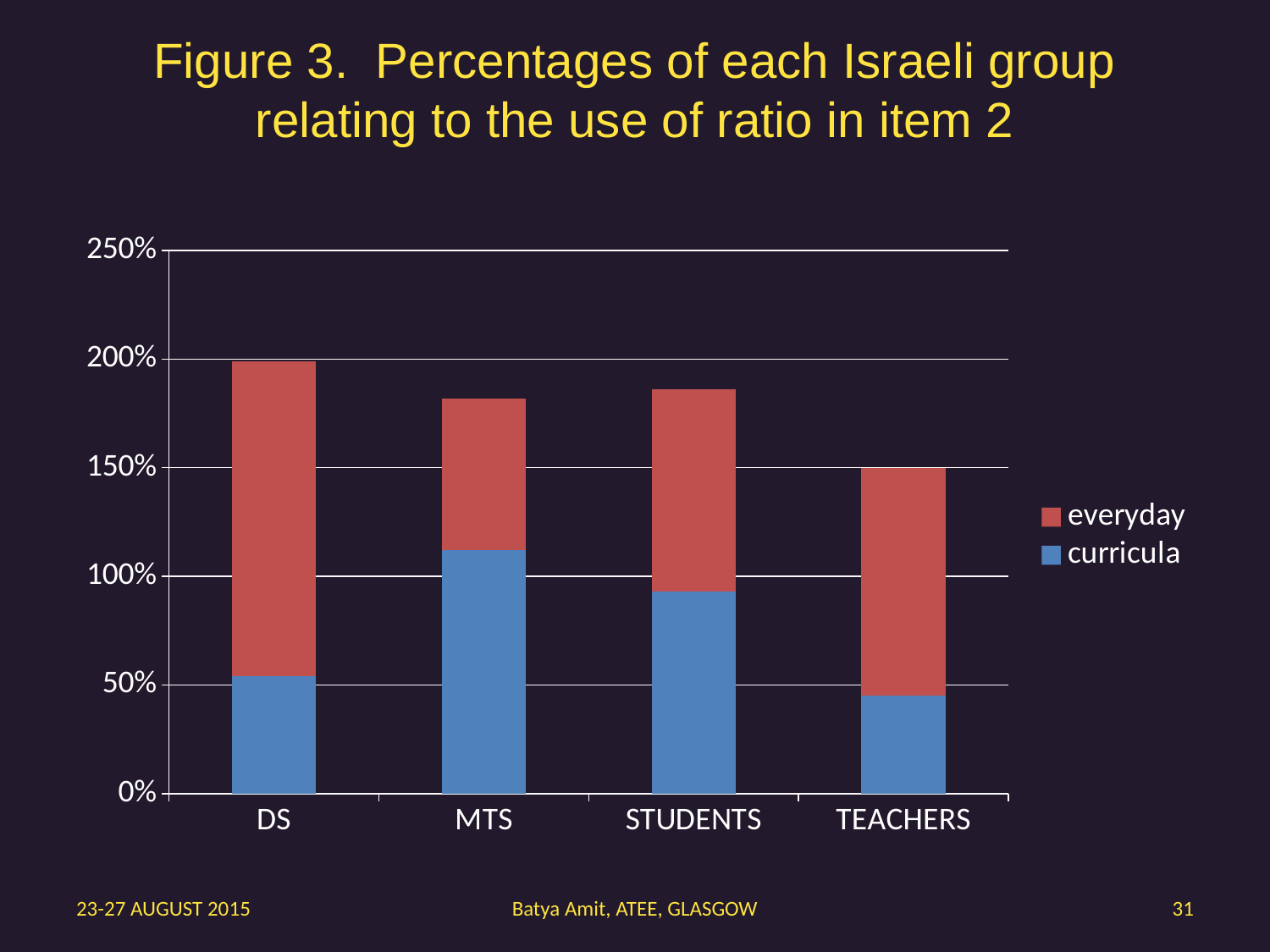
How many series does the legend list? 2 Is the curricula value for MTS greater or less than 100%? greater Which group has the shortest stacked bar overall? TEACHERS Which group has the highest curricula value? MTS Which colour represents the everyday series in the legend? red Is the curricula value for STUDENTS greater or less than 100%? less What kind of chart is shown on the slide? stacked bar chart Which group has the lowest everyday value? MTS Which group has the highest everyday value? DS How many groups (categories) are shown on the x axis? 4 Which group has the tallest stacked bar overall? DS Is the curricula value for MTS larger than the curricula value for STUDENTS? yes